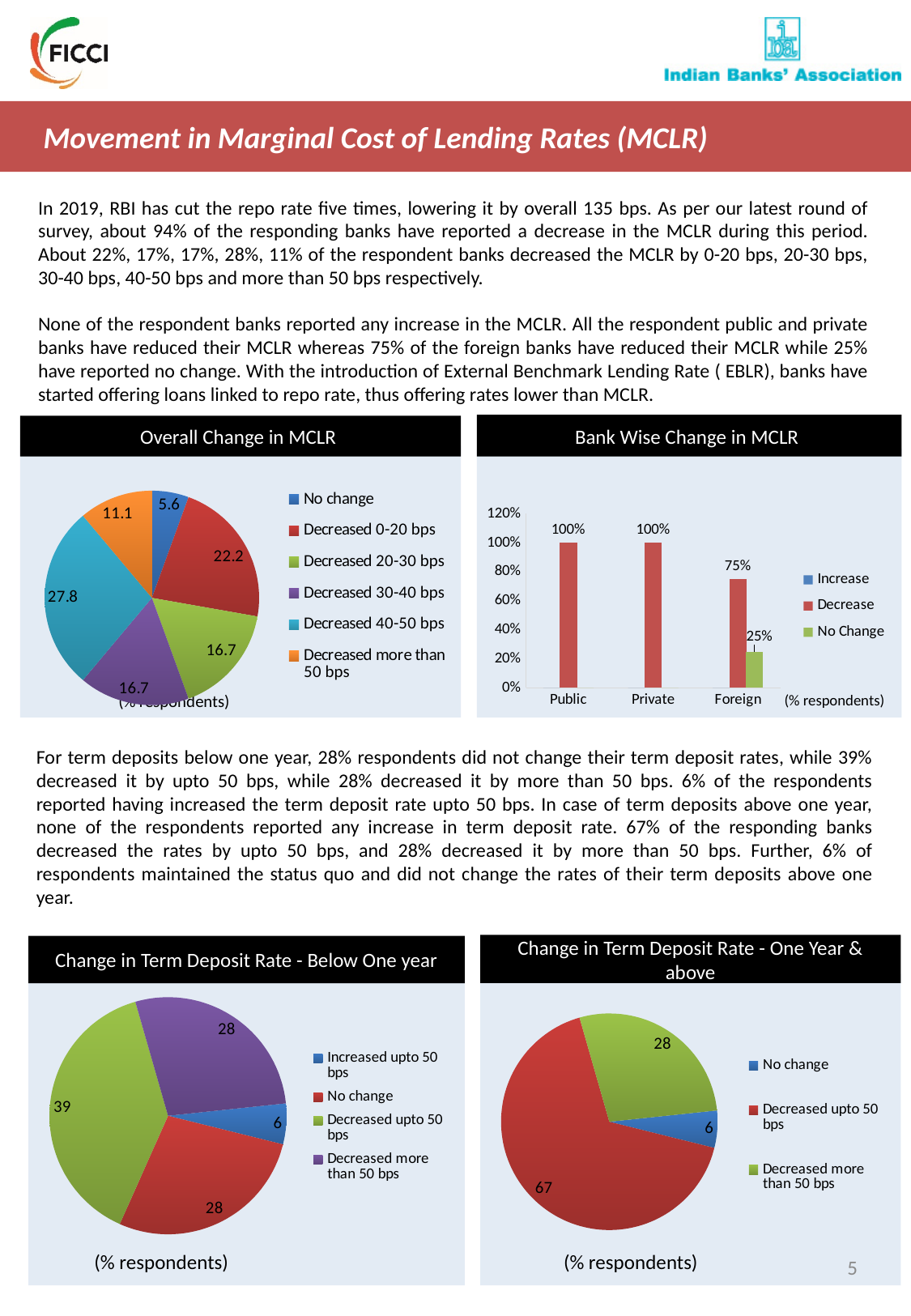
In the 'Change in Term Deposit Rate - Below One year' chart, which is larger: 'No change' or 'Increased upto 50 bps'? No change In the 'Change in Term Deposit Rate - One Year & above' chart, what is the value for 'No change'? 6 In the 'Overall Change in MCLR' chart, what is the difference between 'Decreased 0-20 bps' and 'Decreased more than 50 bps'? 11.1 In the 'Overall Change in MCLR' chart, what is the value for 'Decreased 40-50 bps'? 27.8 What kind of chart is the 'Bank Wise Change in MCLR' chart? Bar chart In the 'Bank Wise Change in MCLR' chart, what is the 'No Change' value for Foreign banks? 25% How many series does the legend of the 'Bank Wise Change in MCLR' chart list? 3 In the 'Change in Term Deposit Rate - Below One year' chart, what is the value for 'Decreased upto 50 bps'? 39 How many categories does the legend of the 'Overall Change in MCLR' chart list? 6 In the 'Change in Term Deposit Rate - One Year & above' chart, which category has the largest slice? Decreased upto 50 bps In the 'Overall Change in MCLR' chart, which category has the smallest slice? No change In the 'Bank Wise Change in MCLR' chart, what is the 'Decrease' value for Foreign banks? 75%